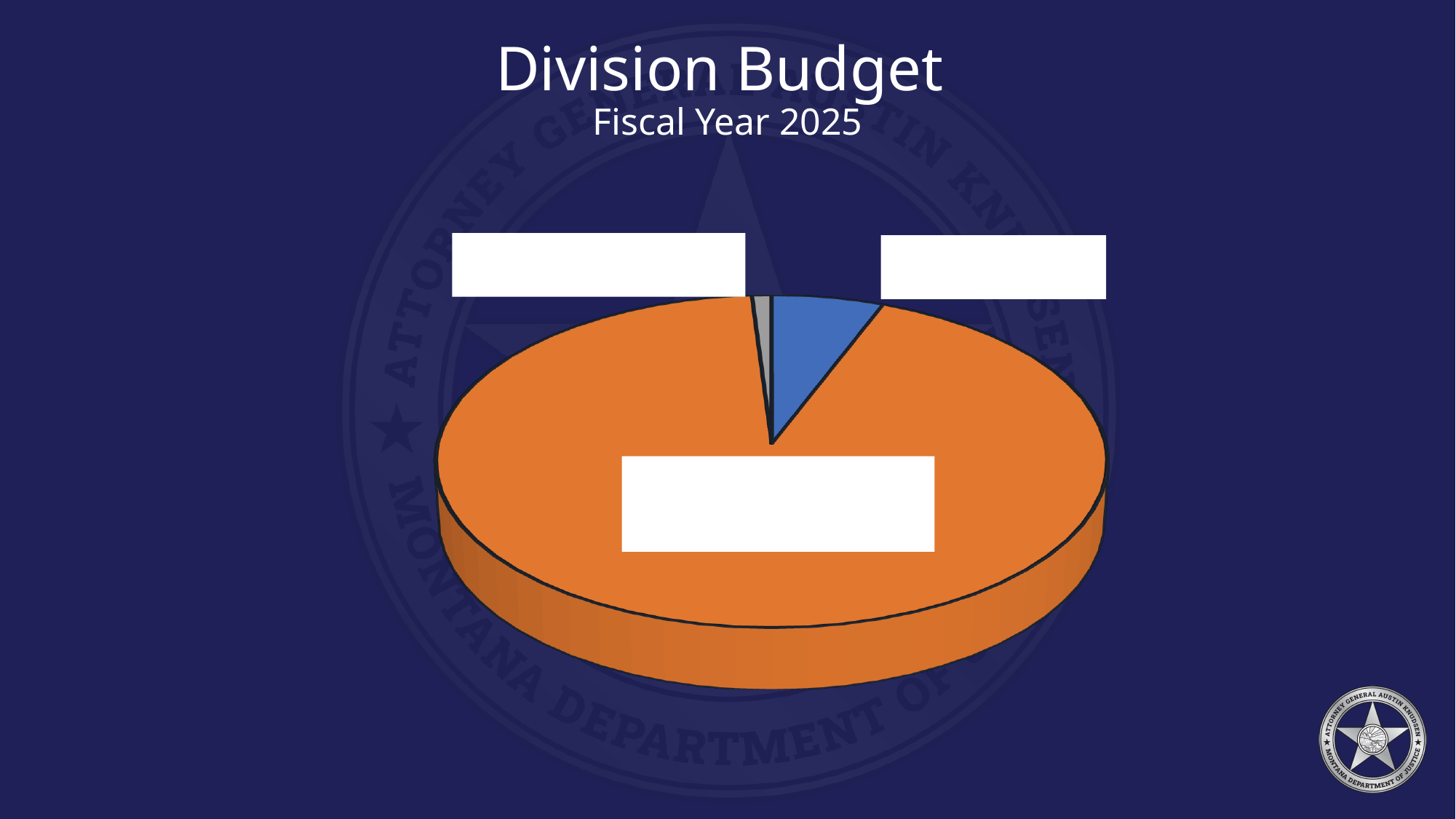
Which slice is larger, the orange slice or the blue slice? Orange Does the orange slice account for more or less than half of the pie? More Which colour slice is the smallest in the pie chart? Gray Which slice is larger, the blue slice or the gray slice? Blue What kind of chart is shown on the slide? Pie chart Which fiscal year does the pie chart's subtitle refer to? Fiscal Year 2025 What is the title of the slide containing the pie chart? Division Budget How many slices does the pie chart have? 3 Which colour slice is the largest in the pie chart? Orange